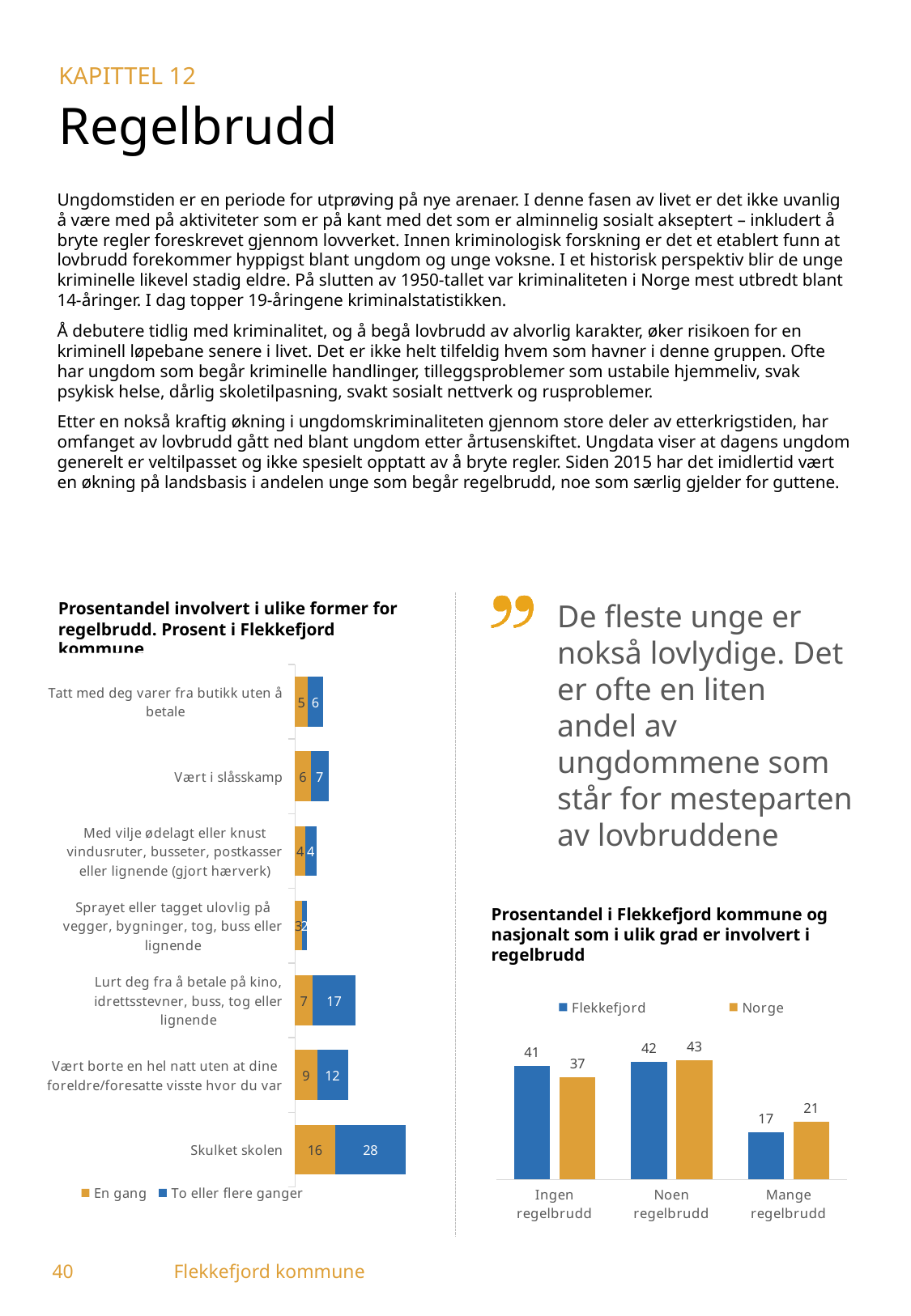
In the left chart (Prosentandel involvert i ulike former for regelbrudd), which category has the highest 'To eller flere ganger' value? Skulket skolen In the left chart (Prosentandel involvert i ulike former for regelbrudd), what is the value of 'En gang' for 'Vært borte en hel natt uten at dine foreldre/foresatte visste hvor du var'? 9 In the left chart (Prosentandel involvert i ulike former for regelbrudd), what is the total of the stacked bar for 'Lurt deg fra å betale på kino, idrettsstevner, buss, tog eller lignende'? 24 In the right chart (Prosentandel i Flekkefjord kommune og nasjonalt), which category has the lowest Flekkefjord value? Mange regelbrudd In the right chart (Prosentandel i Flekkefjord kommune og nasjonalt), what is the difference between Flekkefjord and Norge for 'Ingen regelbrudd'? 4 In the left chart (Prosentandel involvert i ulike former for regelbrudd), how many categories are shown? 7 In the right chart (Prosentandel i Flekkefjord kommune og nasjonalt), which is larger for 'Mange regelbrudd': Flekkefjord or Norge? Norge In the left chart (Prosentandel involvert i ulike former for regelbrudd), what is the value of 'To eller flere ganger' for 'Skulket skolen'? 28 What kind of chart is the right chart (Prosentandel i Flekkefjord kommune og nasjonalt)? Bar chart In the left chart (Prosentandel involvert i ulike former for regelbrudd), what is the total of the stacked bar for 'Skulket skolen'? 44 In the left chart (Prosentandel involvert i ulike former for regelbrudd), how many series does the legend list? 2 In the right chart (Prosentandel i Flekkefjord kommune og nasjonalt), what is the value for Norge in 'Mange regelbrudd'? 21